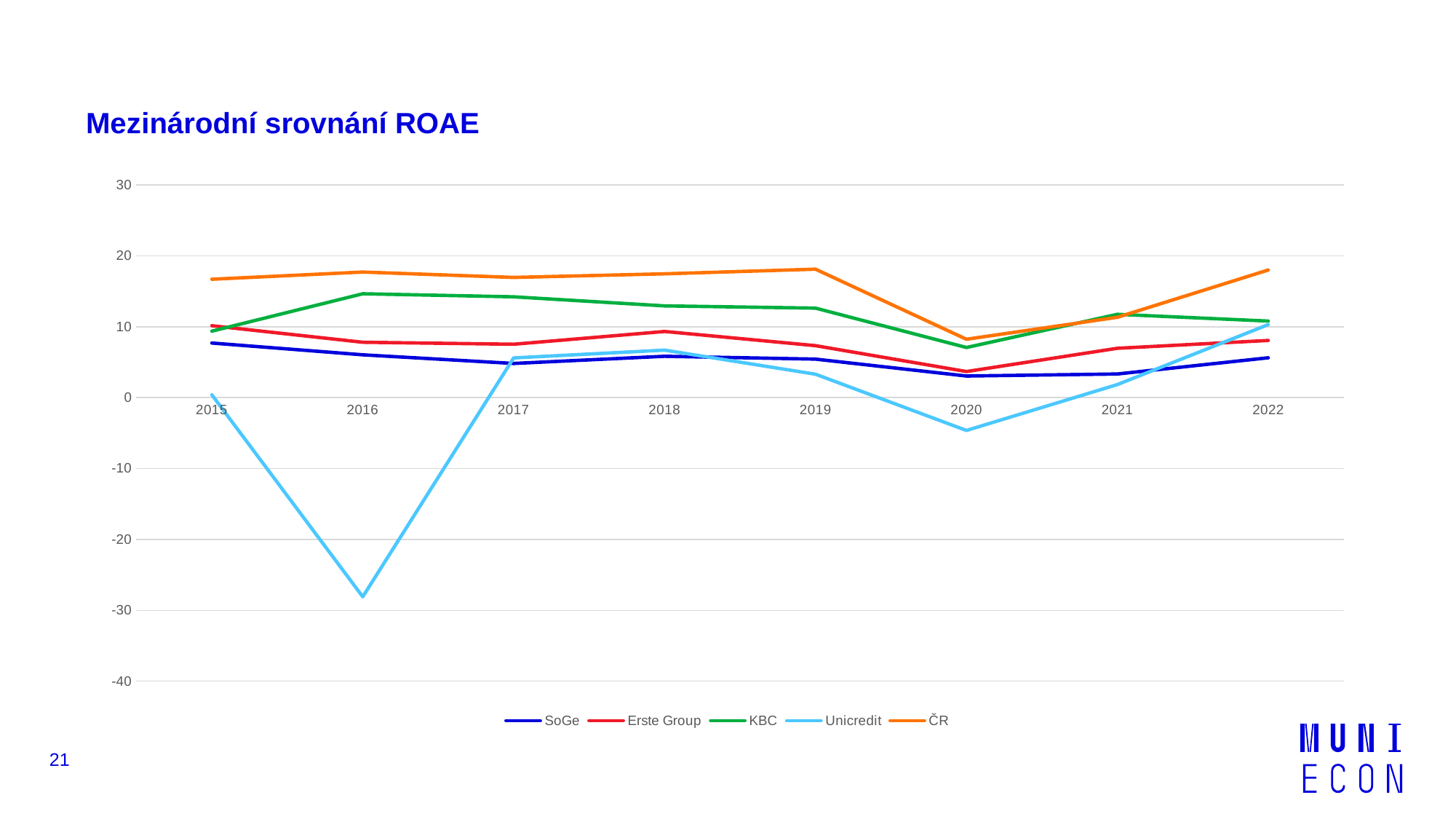
In 2016, which is higher: KBC or Erste Group? KBC Which series has the highest value in 2015? ČR In which year does the Unicredit line reach its lowest value? 2016 Is the value for KBC in 2020 greater or less than 10? less Is the value for Unicredit in 2016 greater or less than -20? less Is the value for ČR in 2019 greater or less than 10? greater In 2020, which is higher: ČR or Unicredit? ČR Which series has the lowest value in 2020? Unicredit What is the title of the chart? Mezinárodní srovnání ROAE How many series does the legend list? 5 What kind of chart is shown on the slide? line chart How many years are plotted along the x axis? 8